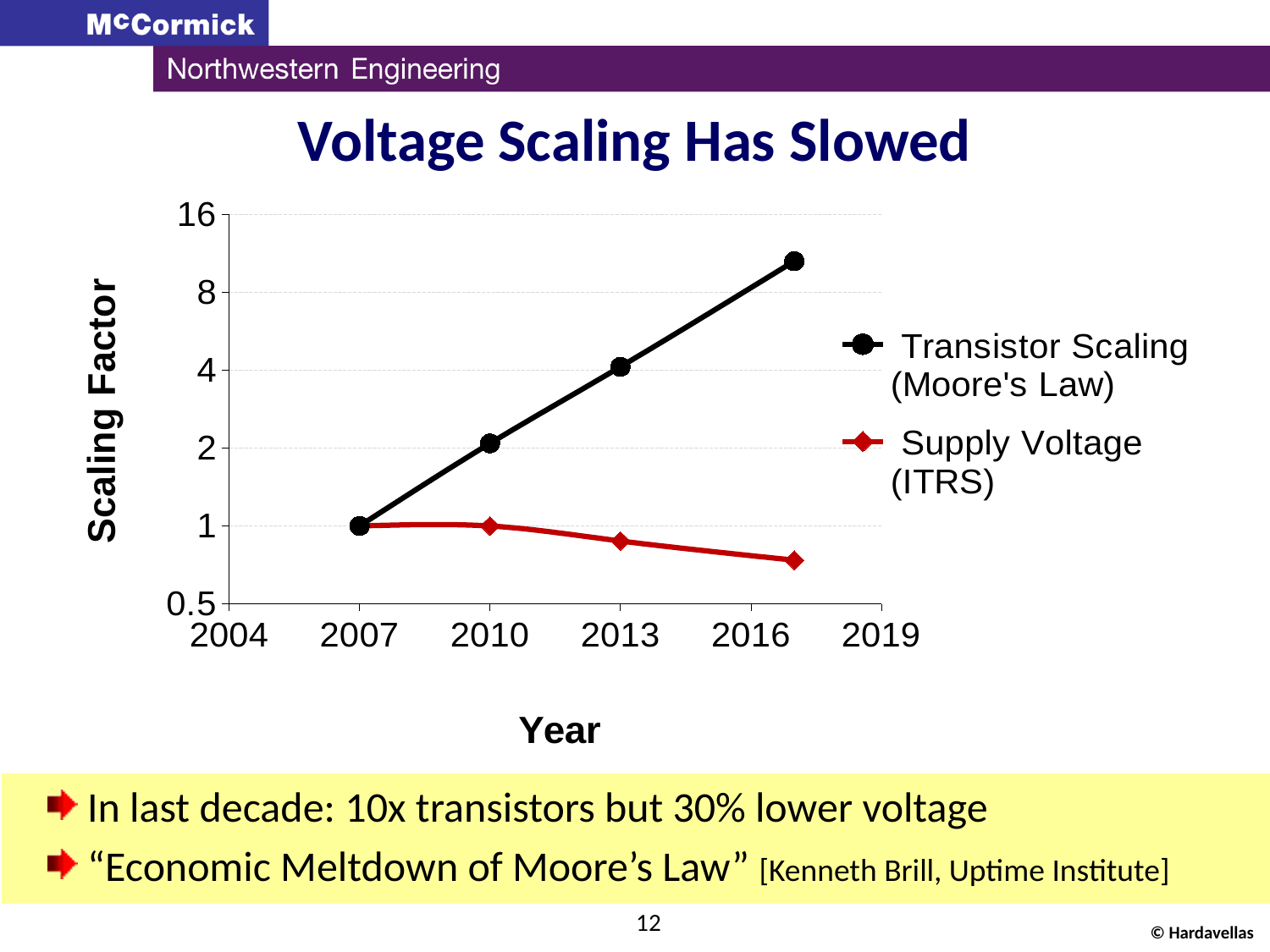
How many data points are plotted for the Transistor Scaling (Moore's Law) series? 4 How many series does the legend list? 2 Is the Supply Voltage (ITRS) value for 2017 greater or less than 1? less In which year is the Supply Voltage (ITRS) scaling factor lowest? 2017 Does the Supply Voltage (ITRS) series rise or fall from 2010 onward? fall Is the Transistor Scaling (Moore's Law) value for 2013 greater or less than 2? greater In 2017, which series has the larger scaling factor, Transistor Scaling (Moore's Law) or Supply Voltage (ITRS)? Transistor Scaling (Moore's Law) Is the Transistor Scaling (Moore's Law) value for 2017 greater or less than 8? greater Does the Transistor Scaling (Moore's Law) series rise or fall as the year increases? rise What is the title of the chart? Voltage Scaling Has Slowed What kind of chart is shown on the slide? line chart What is the scaling factor for Transistor Scaling (Moore's Law) in 2007? 1